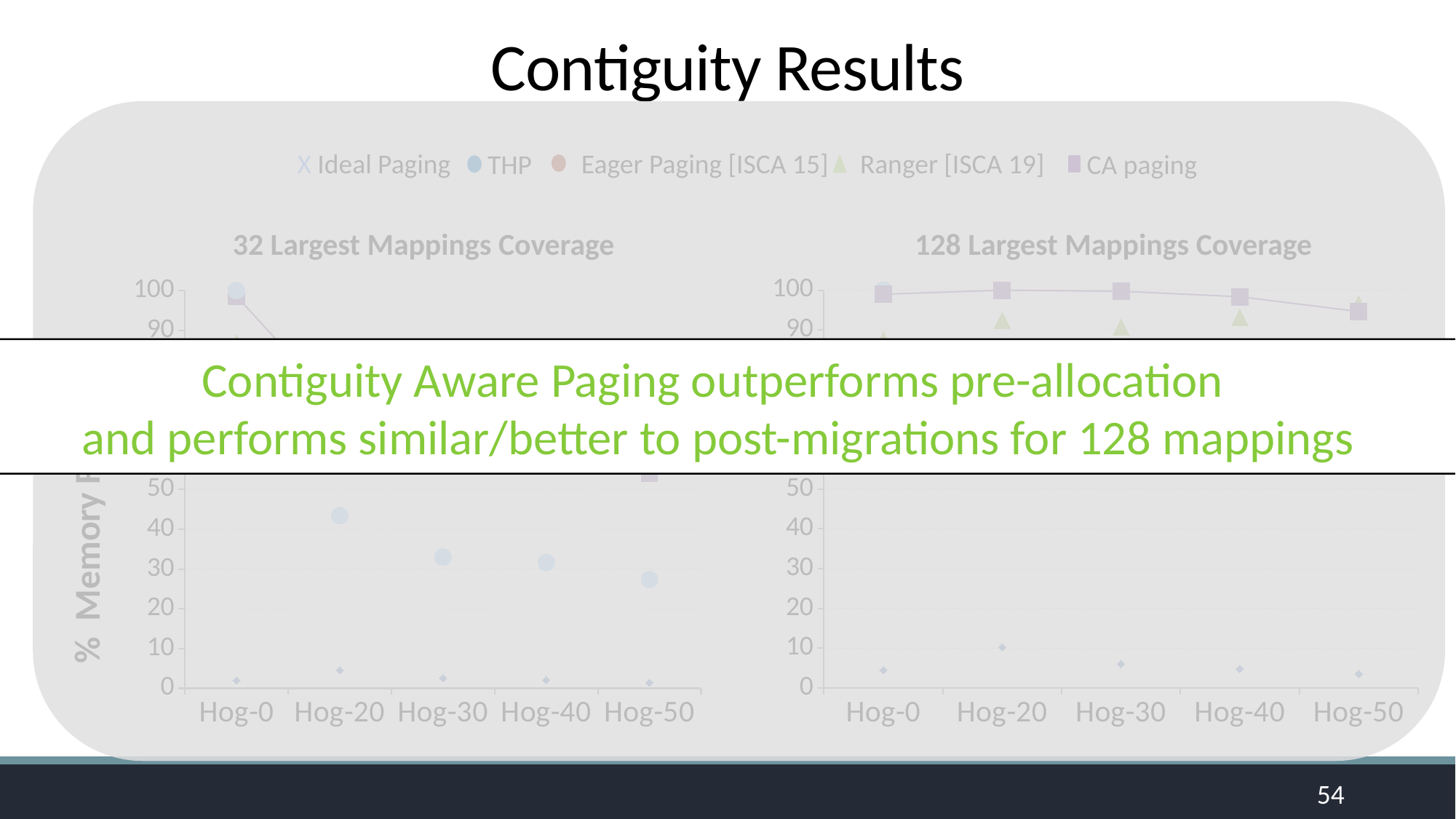
In the 32 Largest Mappings Coverage chart, how many categories are on the x axis? 5 In the 32 Largest Mappings Coverage chart, is the THP value for Hog-20 greater or less than 50? less In the 128 Largest Mappings Coverage chart, is the CA paging value for Hog-20 greater or less than 90? greater In the 32 Largest Mappings Coverage chart, is the THP value for Hog-50 greater or less than 30? less What is the title of the chart on the left? 32 Largest Mappings Coverage How many series does the shared legend list? 5 How many charts are shown on the slide? 2 In the 32 Largest Mappings Coverage chart, does the THP value rise or fall from Hog-0 to Hog-50? fall In the 32 Largest Mappings Coverage chart, which is larger, the THP value for Hog-20 or for Hog-50? Hog-20 What is the title of the chart on the right? 128 Largest Mappings Coverage